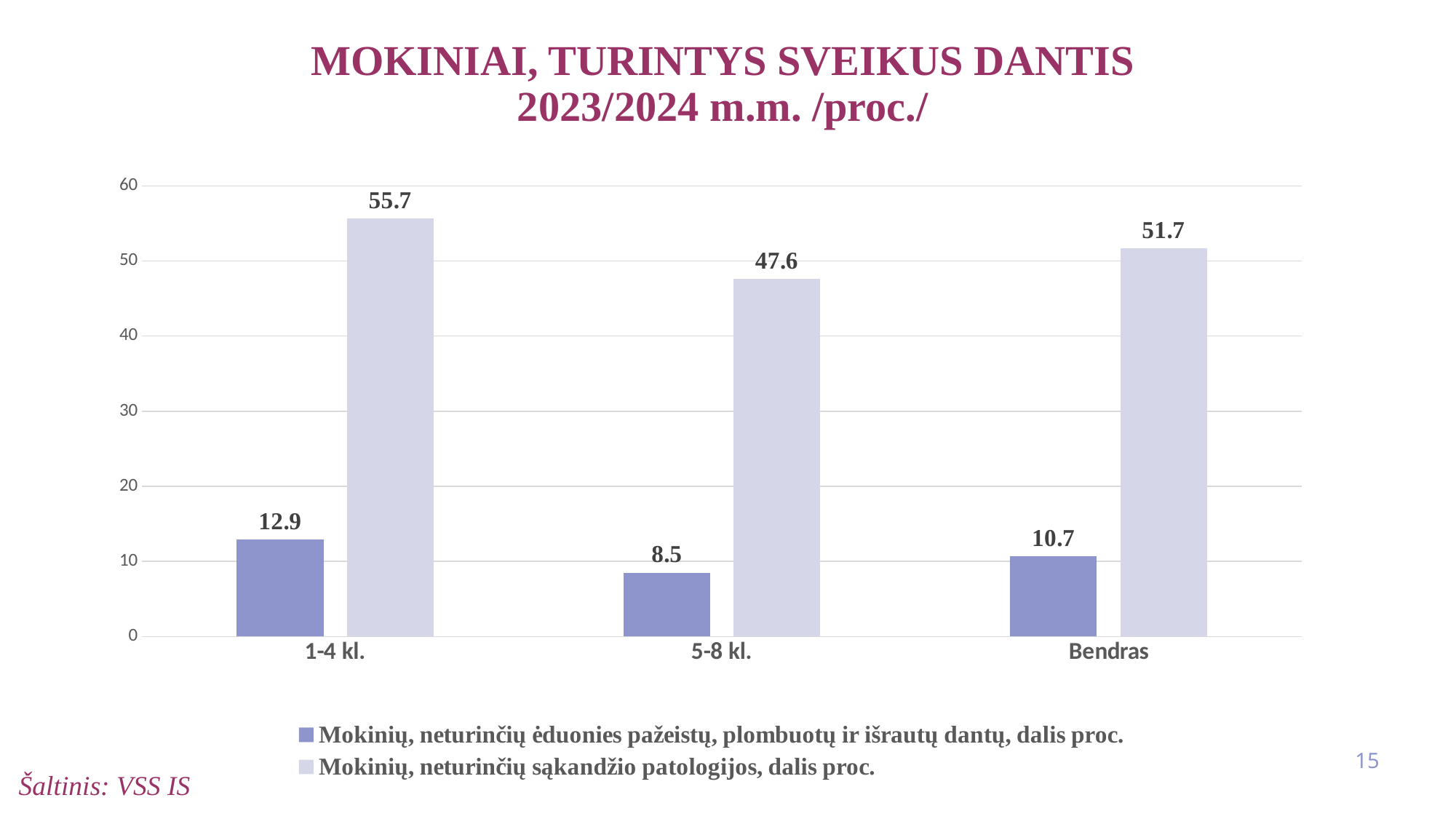
Which category has the highest value in the series 'Mokinių, neturinčių sąkandžio patologijos, dalis proc.'? 1-4 kl. What is the value for 5-8 kl. in the series 'Mokinių, neturinčių sąkandžio patologijos, dalis proc.'? 47.6 How many categories are shown on the x axis? 3 How many series does the legend list? 2 Which category has the lowest value in the series 'Mokinių, neturinčių ėduonies pažeistų, plombuotų ir išrautų dantų, dalis proc.'? 5-8 kl. Which is larger: the Bendras value for 'Mokinių, neturinčių sąkandžio patologijos, dalis proc.' or the 5-8 kl. value for the same series? Bendras What is the title of the chart? MOKINIAI, TURINTYS SVEIKUS DANTIS 2023/2024 m.m. /proc./ What is the value for Bendras in the series 'Mokinių, neturinčių ėduonies pažeistų, plombuotų ir išrautų dantų, dalis proc.'? 10.7 What is the difference between the 1-4 kl. and 5-8 kl. values in the series 'Mokinių, neturinčių sąkandžio patologijos, dalis proc.'? 8.1 Is the 1-4 kl. value for 'Mokinių, neturinčių sąkandžio patologijos, dalis proc.' greater or less than 50? greater What kind of chart is shown on the slide? bar chart What is the value for 1-4 kl. in the series 'Mokinių, neturinčių ėduonies pažeistų, plombuotų ir išrautų dantų, dalis proc.'? 12.9